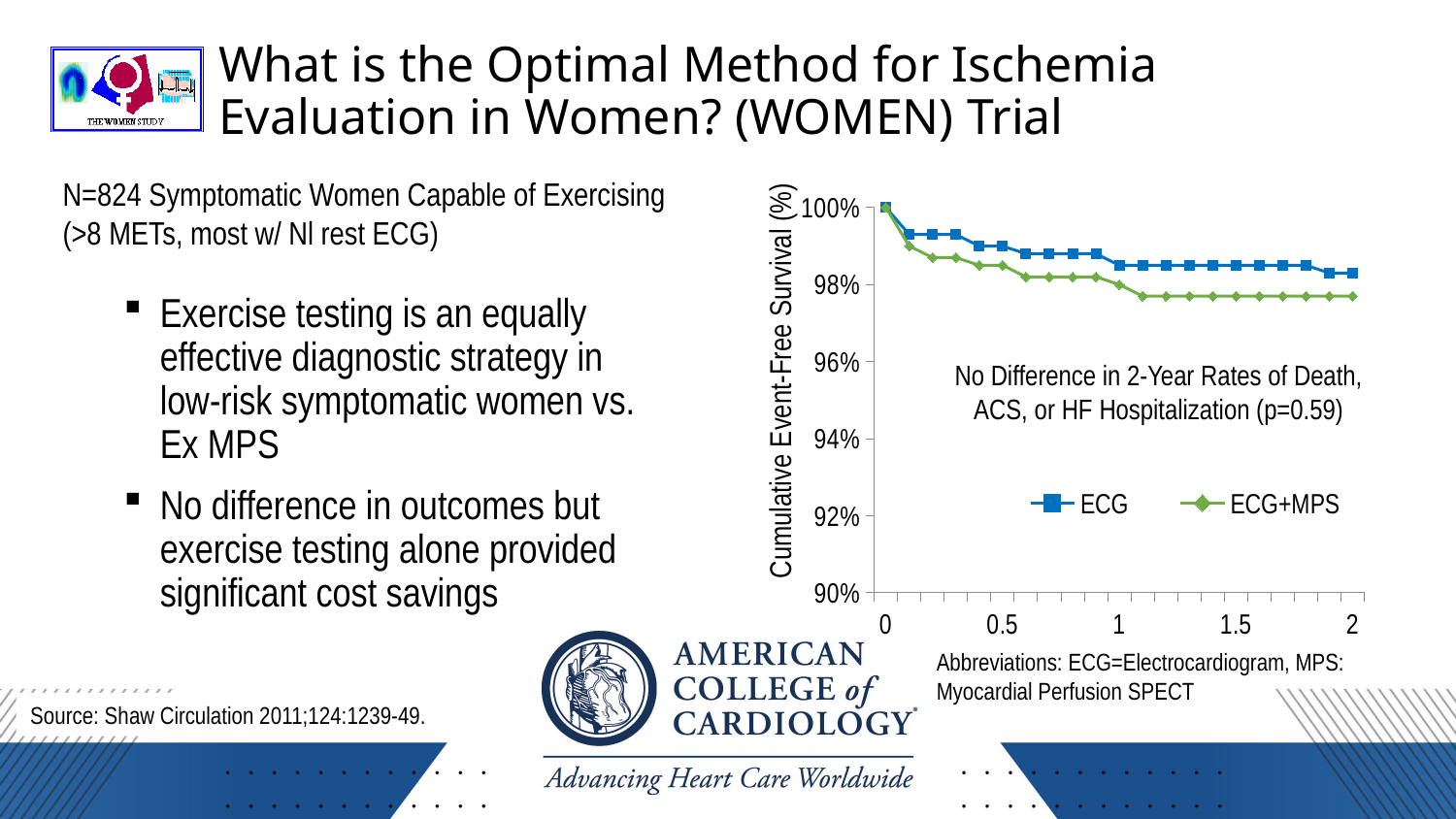
Do the values of the ECG+MPS series rise or fall as you move along the x axis? fall Is the value for ECG at 2 years greater or less than 96%? greater What is the value of the ECG series at time 0? 100% At the end of the x axis (2 years), which series has the higher value, ECG or ECG+MPS? ECG Is the value for ECG+MPS at 1.5 years greater or less than 98%? less Is the value for ECG+MPS at 2 years greater or less than 96%? greater Do the values of the ECG series rise or fall as you move along the x axis? fall What kind of chart is shown on the slide? line chart What are the two series named in the chart legend? ECG and ECG+MPS How many series does the chart legend list? 2 What is the label of the chart's y axis? Cumulative Event-Free Survival (%) What is the value of the ECG+MPS series at time 0? 100%